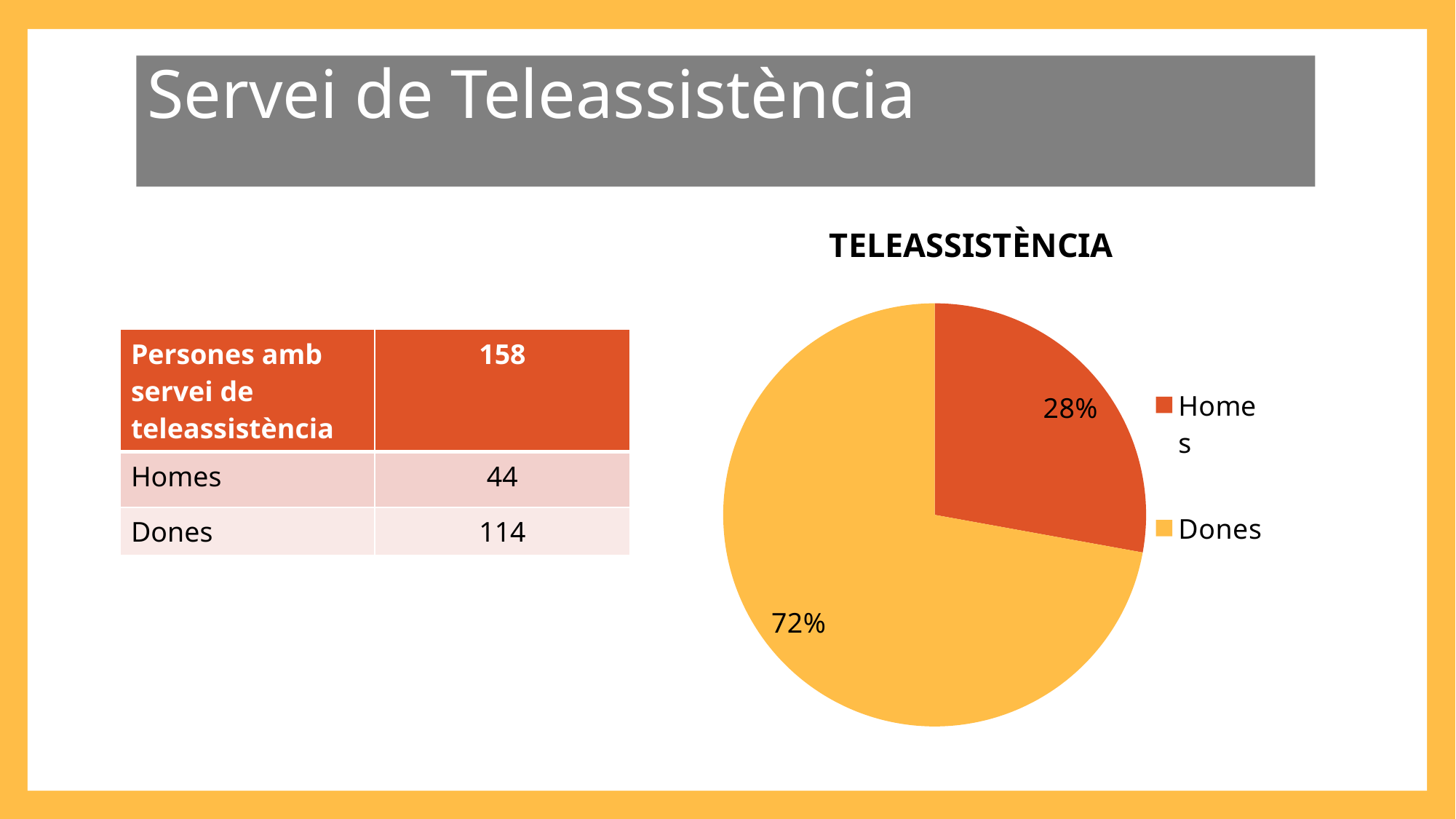
Which slice is larger, Homes or Dones? Dones How many slices does the pie chart have? 2 What percentage of the pie does the Dones slice represent? 72% How many entries does the legend list? 2 Which slice of the pie is the largest? Dones What is the title of the chart? TELEASSISTÈNCIA What percentage of the pie does the Homes slice represent? 28% Which slice of the pie is the smallest? Homes What is the difference in percentage points between the Dones slice and the Homes slice? 44 What kind of chart is shown on the slide? pie chart What colour is the Dones slice in the pie chart? yellow